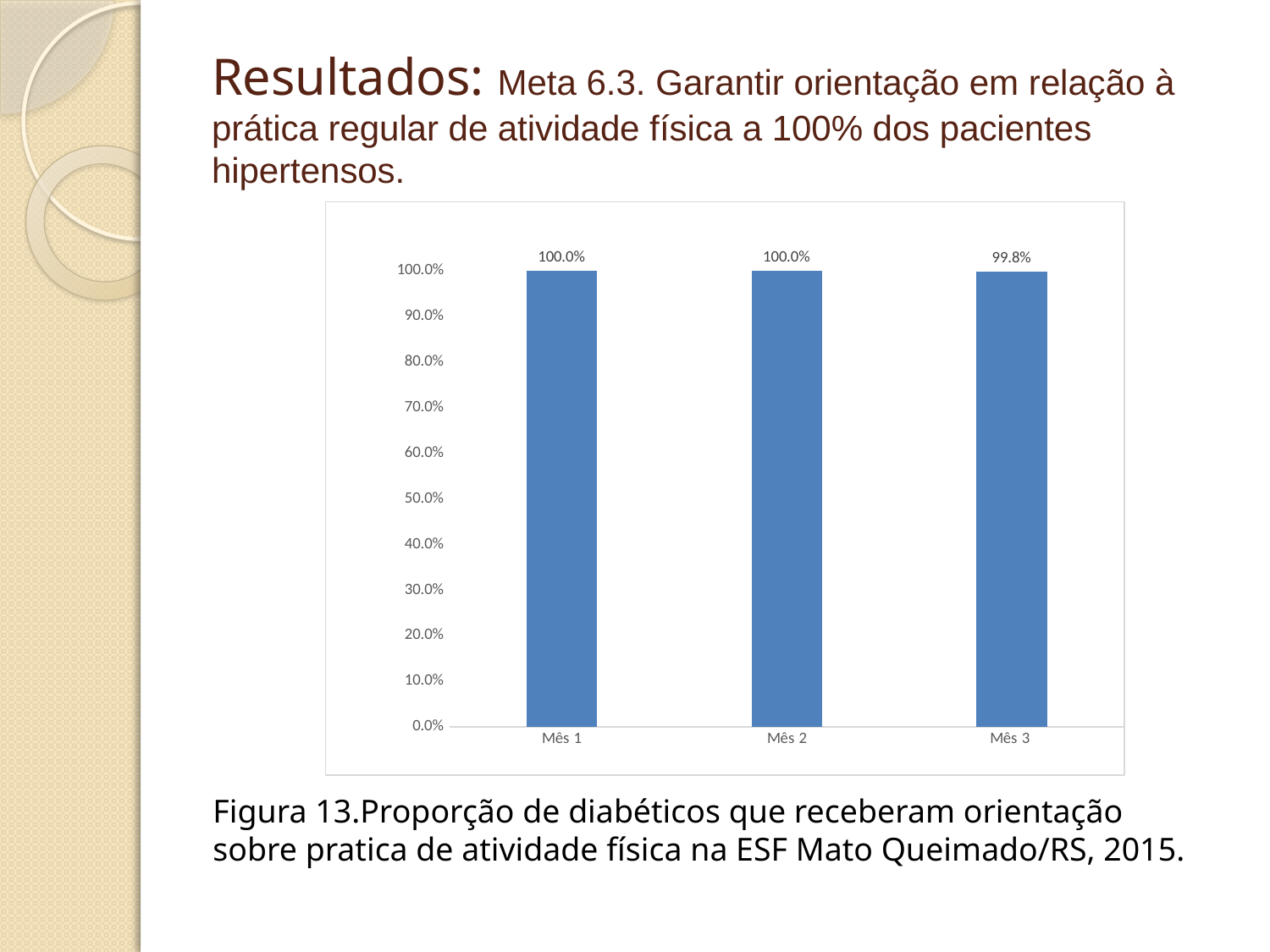
How many months are shown on the x axis? 3 What colour are the bars in the chart? blue Do the values rise, fall or stay the same from Mês 1 to Mês 3? fall slightly What is the highest value shown on the y axis? 100.0% What kind of chart is shown on the slide? bar chart What is the value for Mês 2? 100.0% What is the difference between the values for Mês 1 and Mês 3? 0.2% What is the value for Mês 3? 99.8% Which is larger, the value for Mês 2 or the value for Mês 3? Mês 2 What is the value for Mês 1? 100.0% Is the value for Mês 3 greater or less than 90.0%? greater Which month has the lowest value? Mês 3